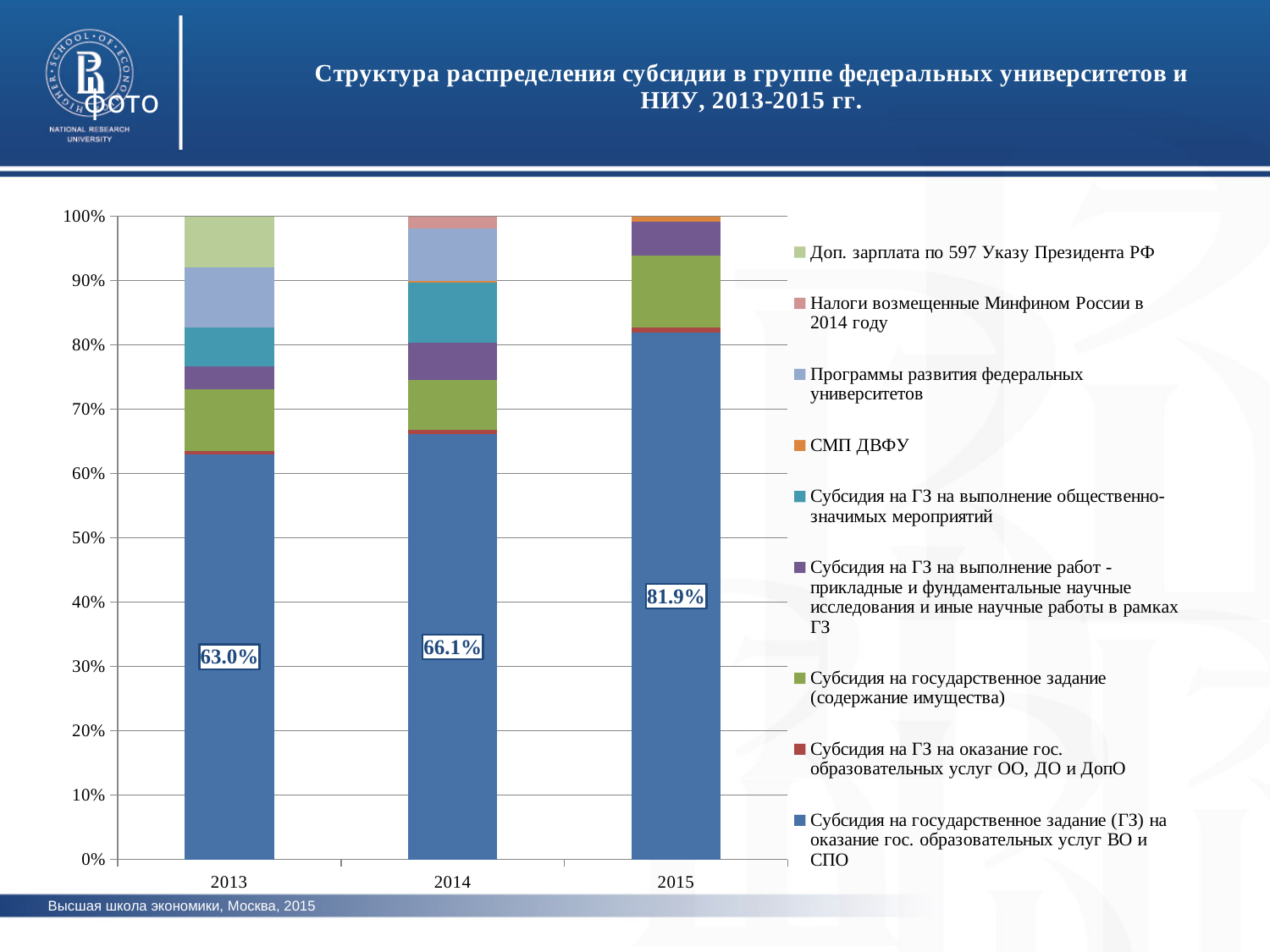
In which year is the labelled share of the bottom series (ГЗ на оказание гос. образовательных услуг ВО и СПО) lowest? 2013 What is the labelled share of 'Субсидия на государственное задание (ГЗ) на оказание гос. образовательных услуг ВО и СПО' in 2013? 63.0% What is the labelled share of 'Субсидия на государственное задание (ГЗ) на оказание гос. образовательных услуг ВО и СПО' in 2014? 66.1% How many series does the chart legend list? 9 In which year is the labelled share of the bottom series (ГЗ на оказание гос. образовательных услуг ВО и СПО) highest? 2015 What is the labelled share of 'Субсидия на государственное задание (ГЗ) на оказание гос. образовательных услуг ВО и СПО' in 2015? 81.9% What kind of chart is shown on the slide? stacked bar chart How many years (categories) are shown on the x axis of the chart? 3 Which year has the larger labelled share for the bottom series, 2013 or 2014? 2014 Which series appears only in the 2013 bar, at the top, in light green? Доп. зарплата по 597 Указу Президента РФ By how many percentage points did the labelled share of the bottom series change from 2013 to 2015? 18.9 percentage points Does the labelled share of the bottom series rise or fall from 2013 to 2015? rise